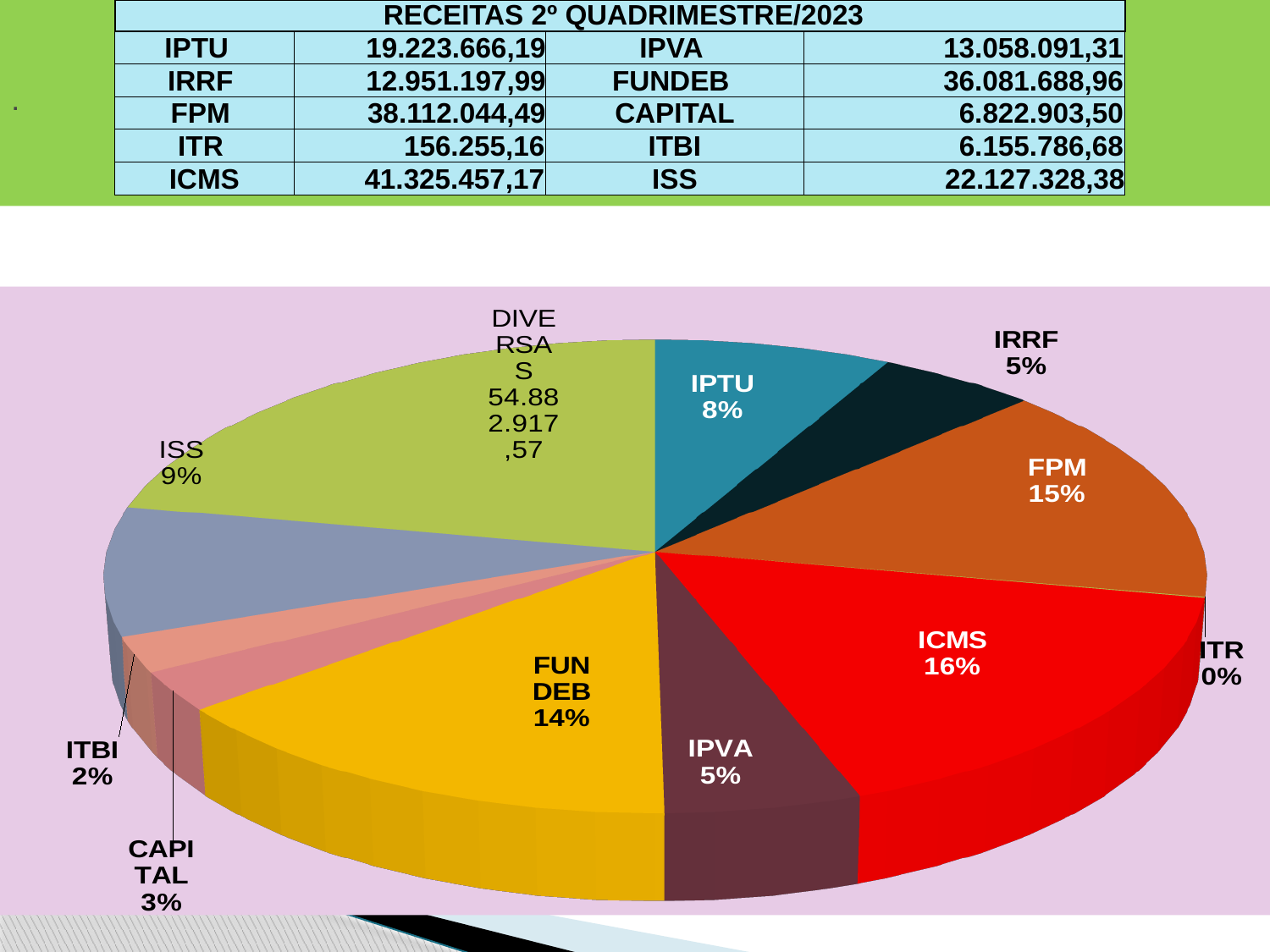
What value is printed on the DIVERSAS slice label? 54.882.917,57 Which has a larger share of the pie, ISS or IPTU? ISS How many slices does the pie chart have? 11 Which category has the lowest percentage label in the pie chart? ITR What percentage is shown for FPM in the pie chart? 15% Which category has the highest percentage label in the pie chart? ICMS What percentage is shown for ITBI in the pie chart? 2% What kind of chart is shown on the slide? Pie chart How many percentage points larger is FUNDEB's share than IPVA's share? 9 percentage points What percentage is shown for FUNDEB in the pie chart? 14% What percentage is shown for ITR in the pie chart? 0% What percentage of the pie does ICMS represent? 16%